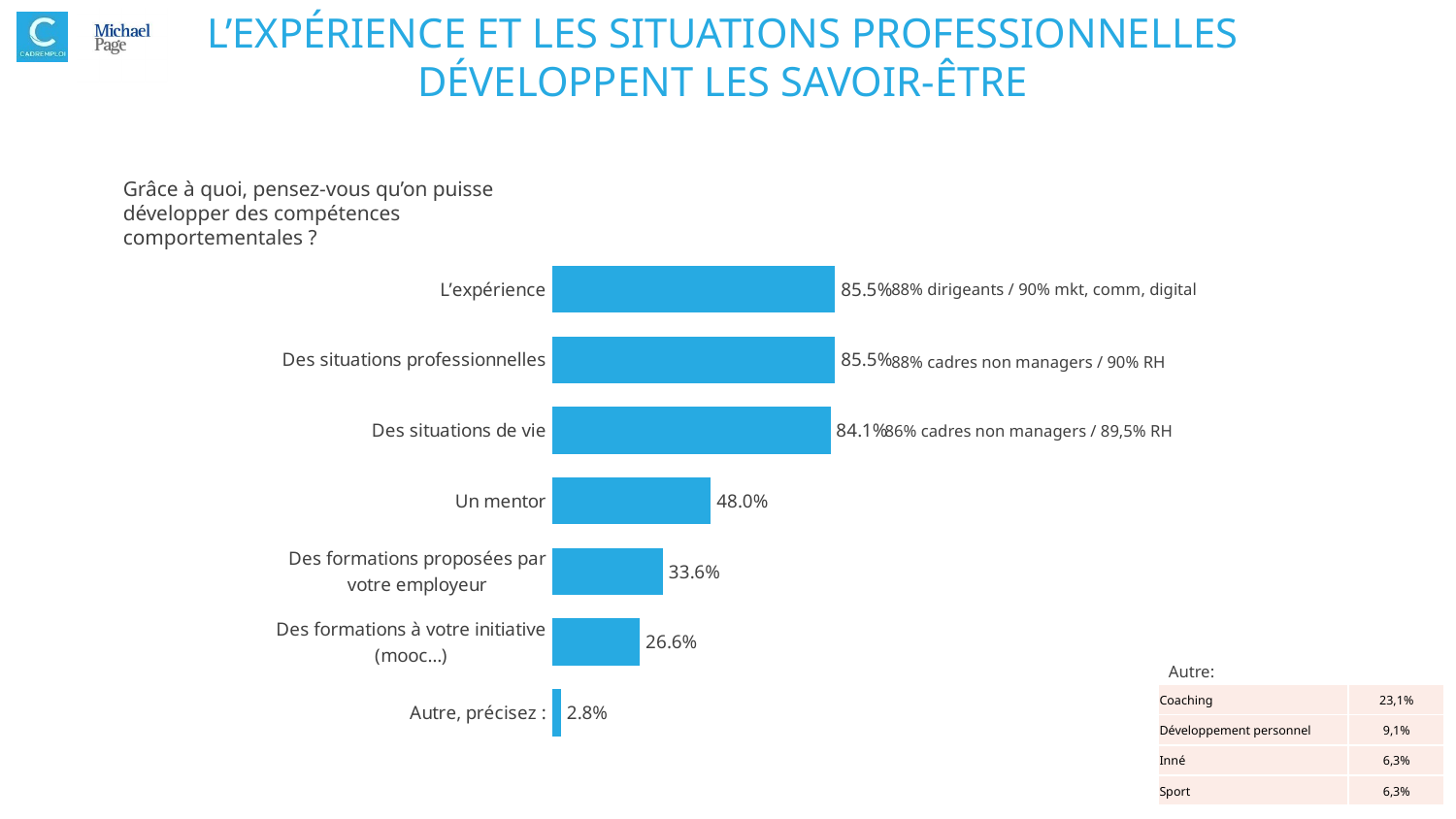
Which is larger, the value for "Un mentor" or the value for "Des formations à votre initiative (mooc…)"? Un mentor What is the value for "Un mentor"? 48.0% What is the value for "Autre, précisez :"? 2.8% What kind of chart is shown on the slide? Bar chart How many categories are shown in the bar chart? 7 What is the value for "Des formations proposées par votre employeur"? 33.6% What is the value for "Des situations de vie"? 84.1% What is the value for "Des formations à votre initiative (mooc…)"? 26.6% What is the difference between the values for "Un mentor" and "Des formations proposées par votre employeur"? 14.4% What is the difference between the values for "L'expérience" and "Des situations de vie"? 1.4% Which category has the lowest value? Autre, précisez : What colour are the bars in the chart? Blue